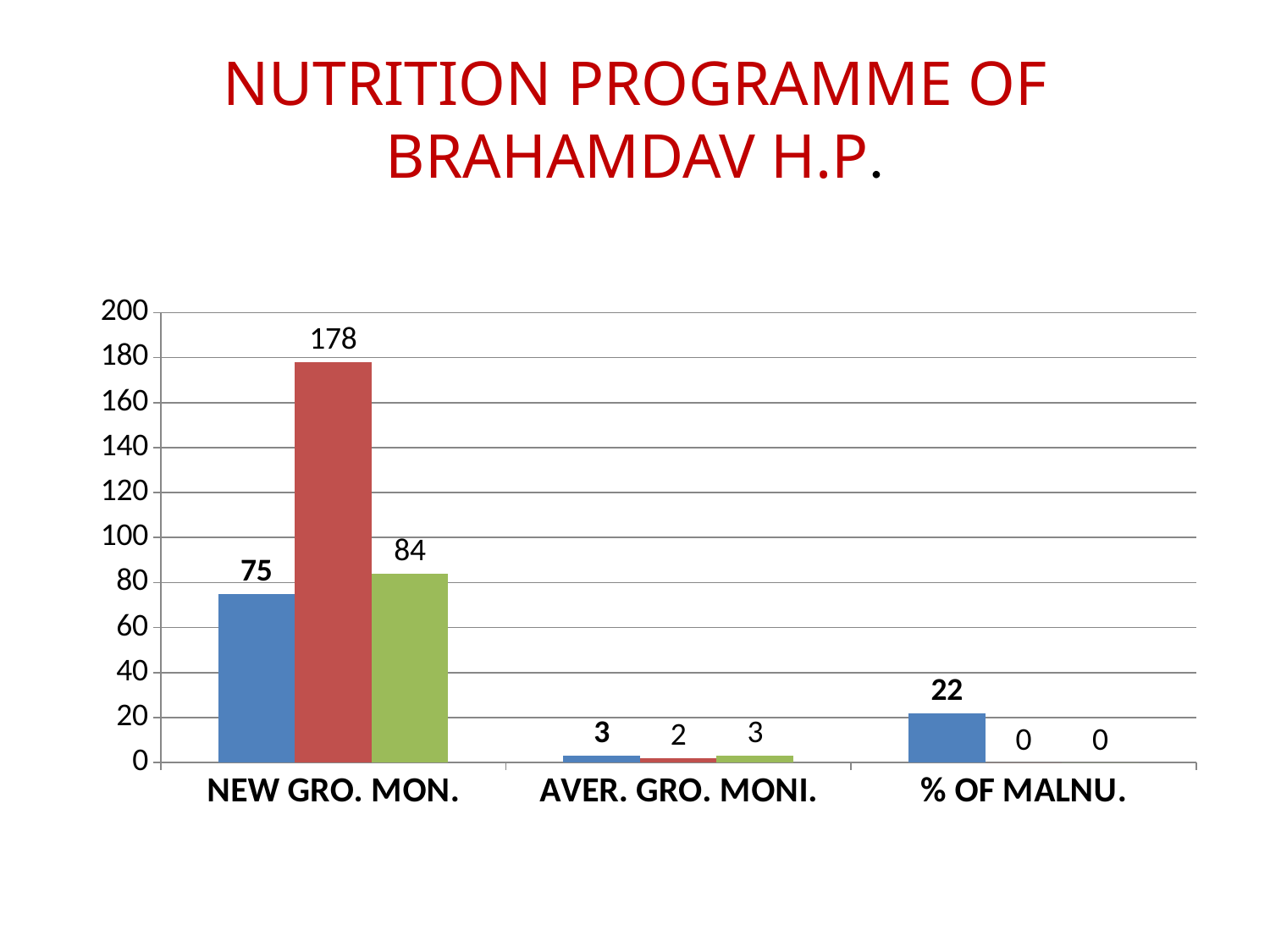
What is the value of the red bar for AVER. GRO. MONI.? 2 What is the value of the red bar for NEW GRO. MON.? 178 Which category has the lowest blue bar? AVER. GRO. MONI. For NEW GRO. MON., which is larger, the green bar or the blue bar? the green bar What is the value of the blue bar for % OF MALNU.? 22 What is the difference between the red bar and the blue bar for NEW GRO. MON.? 103 What is the value of the green bar for NEW GRO. MON.? 84 What kind of chart is shown on the slide? bar chart What is the title of the slide? NUTRITION PROGRAMME OF BRAHAMDAV H.P. What is the value of the blue bar for NEW GRO. MON.? 75 How many categories are shown on the x axis? 3 Which category has the highest red bar? NEW GRO. MON.